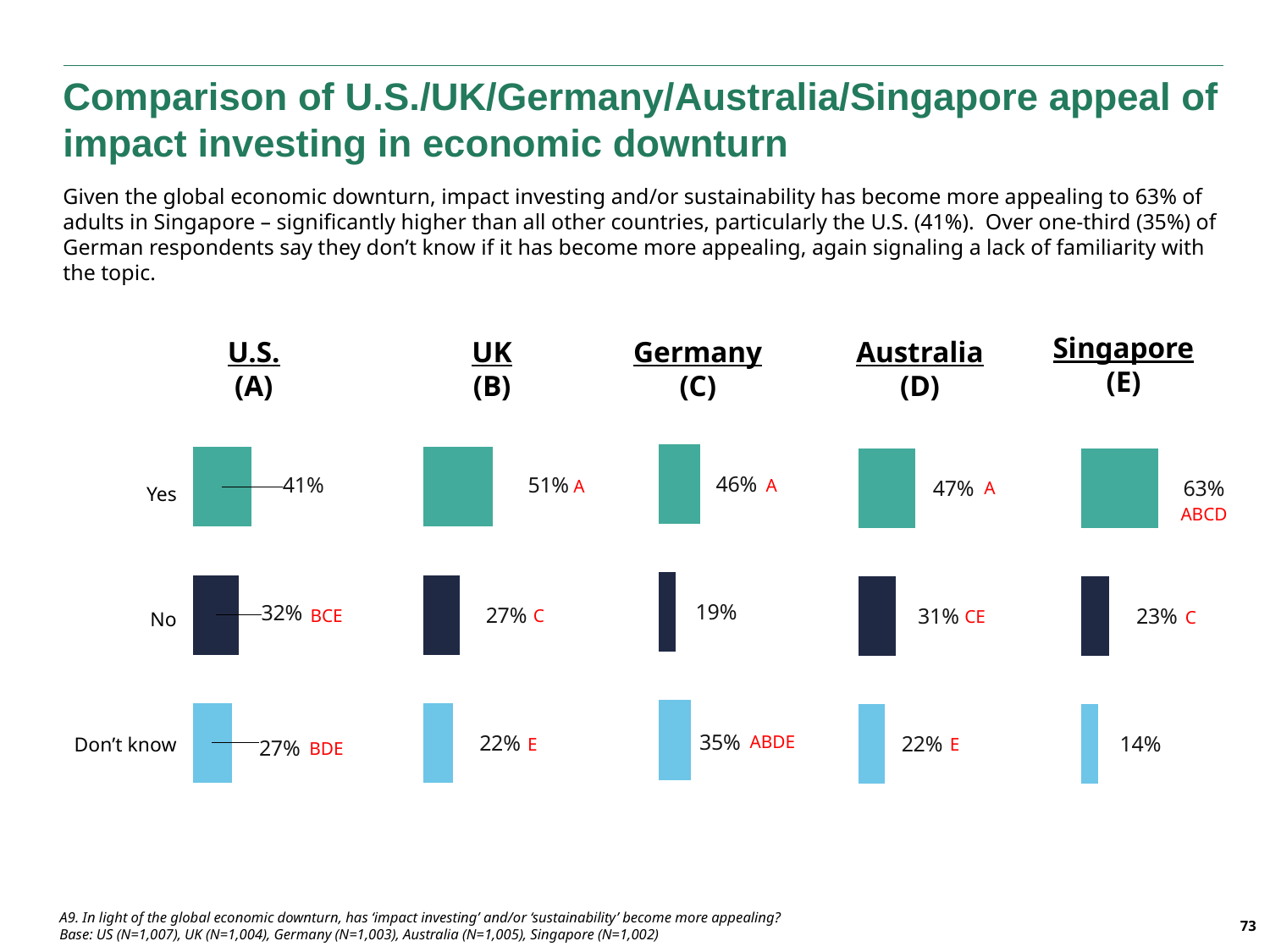
What is the difference between the Yes percentage in the Singapore (E) chart and the Yes percentage in the U.S. (A) chart? 22% In the Germany (C) chart, what percentage answered Don't know? 35% In the Singapore (E) chart, what percentage answered Yes? 63% What type of chart is used to show the responses for each country? Bar chart In the Australia (D) chart, which response category has the lowest percentage? Don't know In the U.S. (A) chart, what percentage answered Yes? 41% How many response categories are shown in each country chart? 3 Which is larger: the No percentage in the U.S. (A) chart or the No percentage in the Australia (D) chart? U.S. (A) In the UK (B) chart, what percentage answered No? 27% In the Germany (C) chart, what is the difference between the Don't know percentage and the No percentage? 16% Across the five country charts, which country has the lowest Don't know percentage? Singapore Across the five country charts, which country has the highest Yes percentage? Singapore